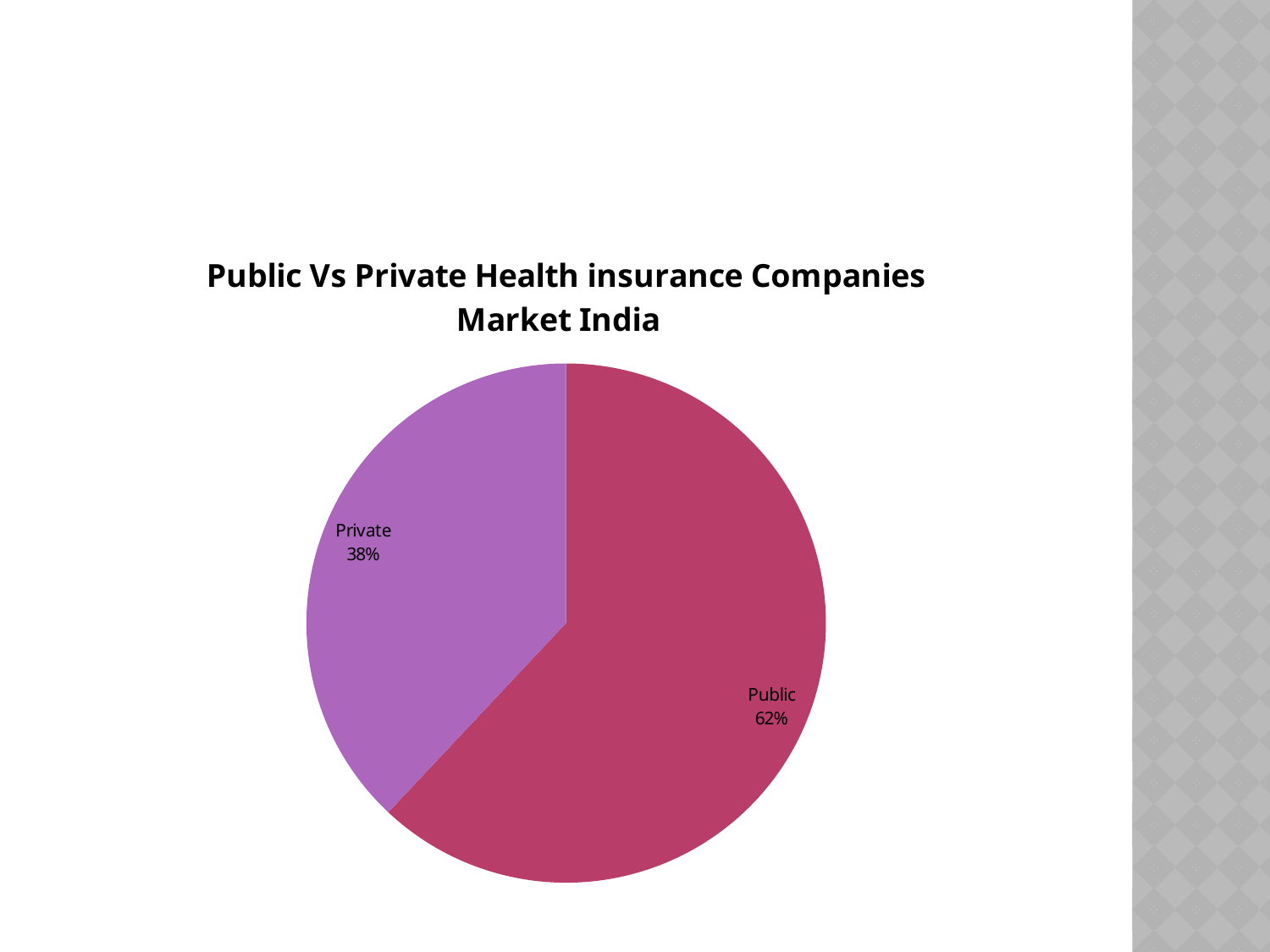
Which is larger, the Public slice or the Private slice? Public What is the title of the chart? Public Vs Private Health insurance Companies Market India Which slice is the smallest in the pie chart? Private Is the share for Private greater or less than 50%? less Is the share for Public greater or less than 50%? greater What share of the pie does the Public slice represent? 62% What colour is the Private slice? Purple What share of the pie does the Private slice represent? 38% What kind of chart is shown on the slide? Pie chart What is the difference in percentage points between the Public and Private slices? 24% How many slices does the pie chart have? 2 Which slice is the largest in the pie chart? Public